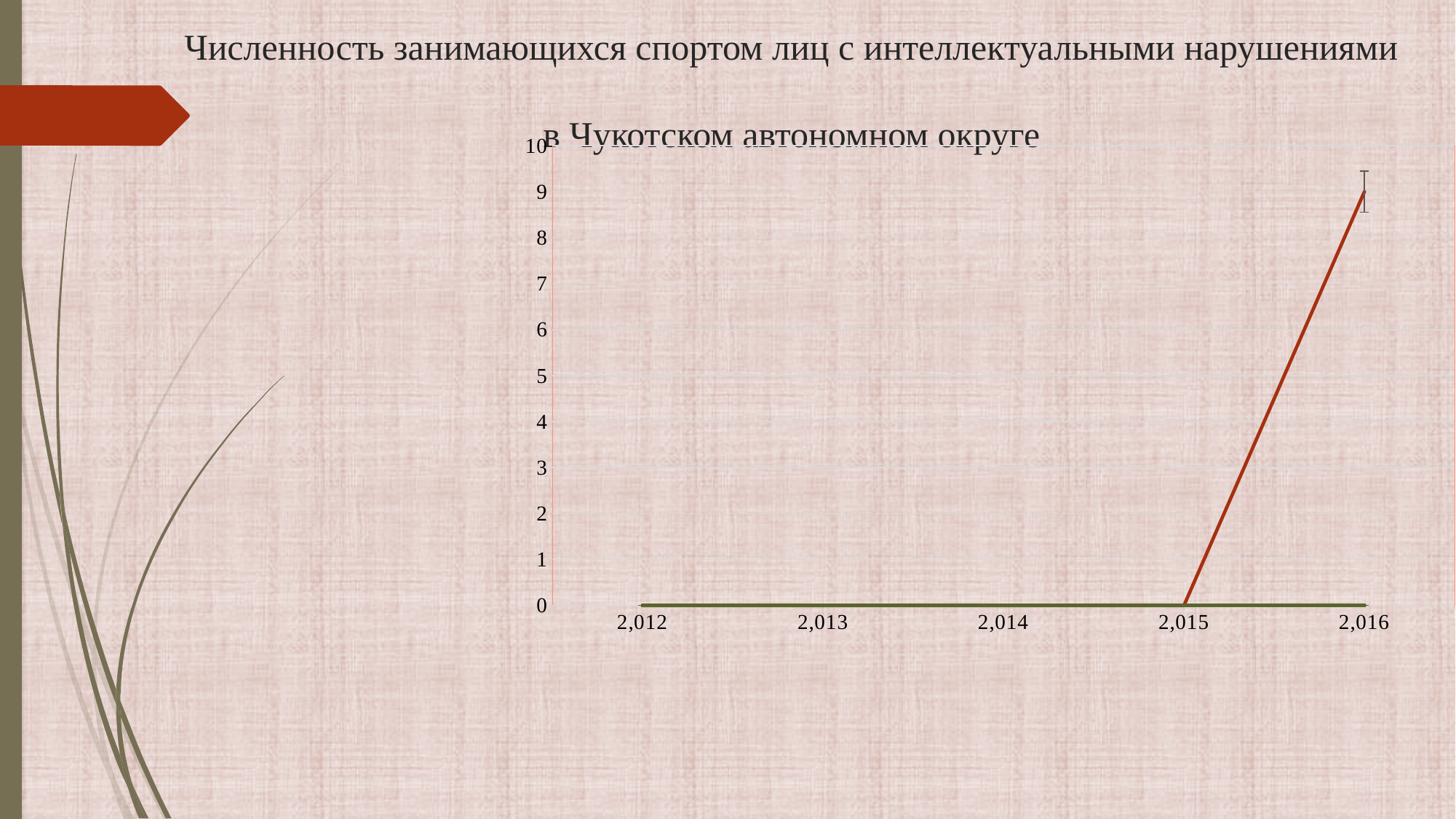
What is the first year labelled on the x axis? 2,012 By how much does the red line increase from 2,015 to 2,016? 9 What kind of chart is shown on the slide? line chart What is the value of the red line in 2,015? 0 What is the highest value shown on the y axis? 10 Which is larger in 2,016: the value of the red line or the value of the green line? the red line How many years are labelled on the x axis? 5 In which year does the red line reach its highest value? 2,016 Is the value of the red line in 2,016 greater or less than 5? greater What is the last year labelled on the x axis? 2,016 Does the red line rise or fall between 2,015 and 2,016? rise What value does the red line reach in 2,016? 9